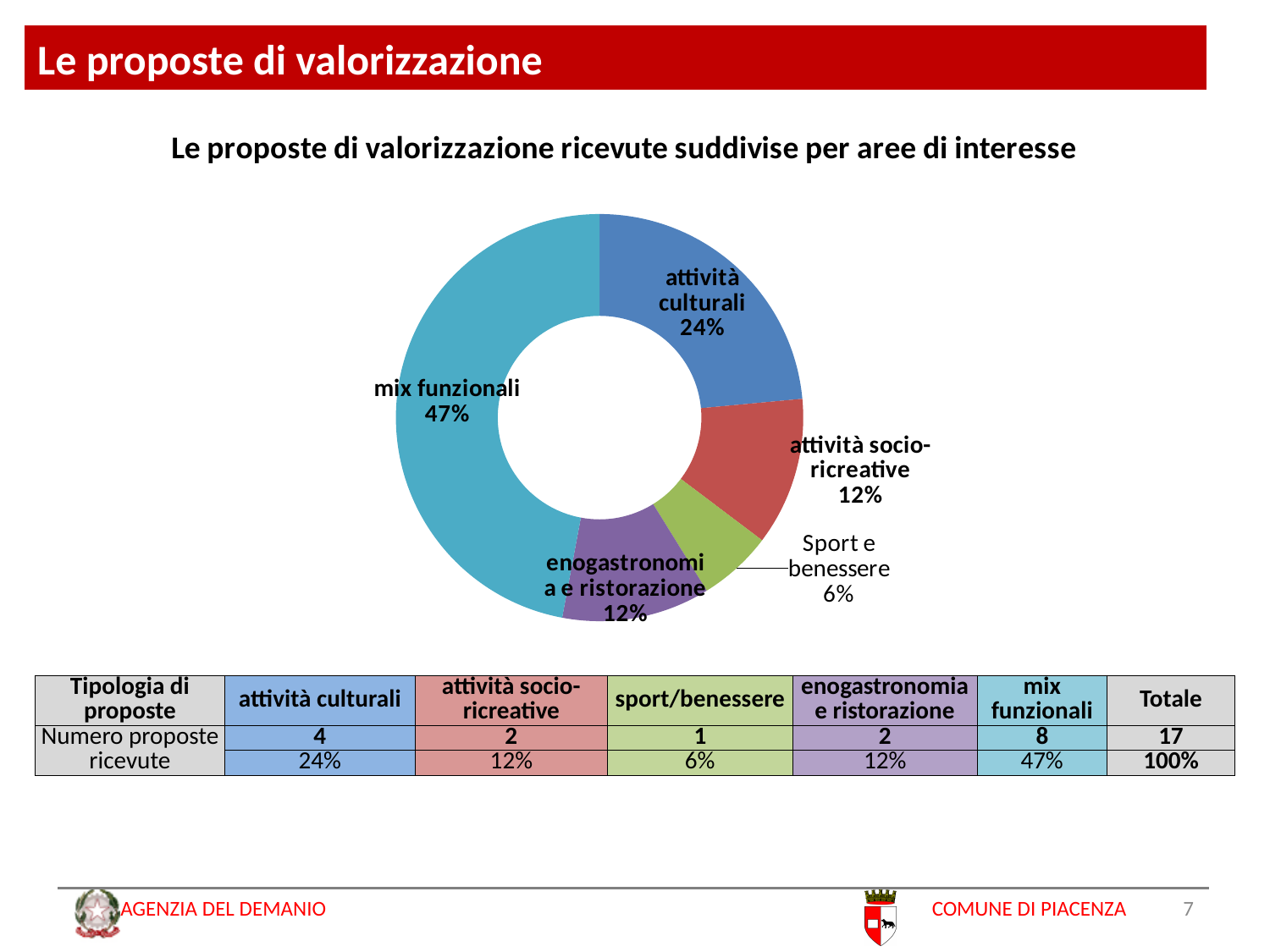
What kind of chart is shown on the slide? Doughnut (pie) chart What colour is the 'mix funzionali' slice in the chart? Teal/light blue Which category has the smallest slice in the chart? Sport e benessere Which is larger in the chart: 'attività culturali' or 'enogastronomia e ristorazione'? attività culturali How many categories are shown in the doughnut chart? 5 What percentage is shown for 'Sport e benessere' in the chart? 6% What share of the doughnut chart does the 'mix funzionali' slice represent? 47% What is the difference in percentage points between 'mix funzionali' and 'attività culturali'? 23 percentage points What is the title of the chart? Le proposte di valorizzazione ricevute suddivise per aree di interesse What percentage is shown for 'attività culturali' in the chart? 24% Which category has the largest slice in the chart? mix funzionali What percentage is shown for 'attività socio-ricreative' in the chart? 12%